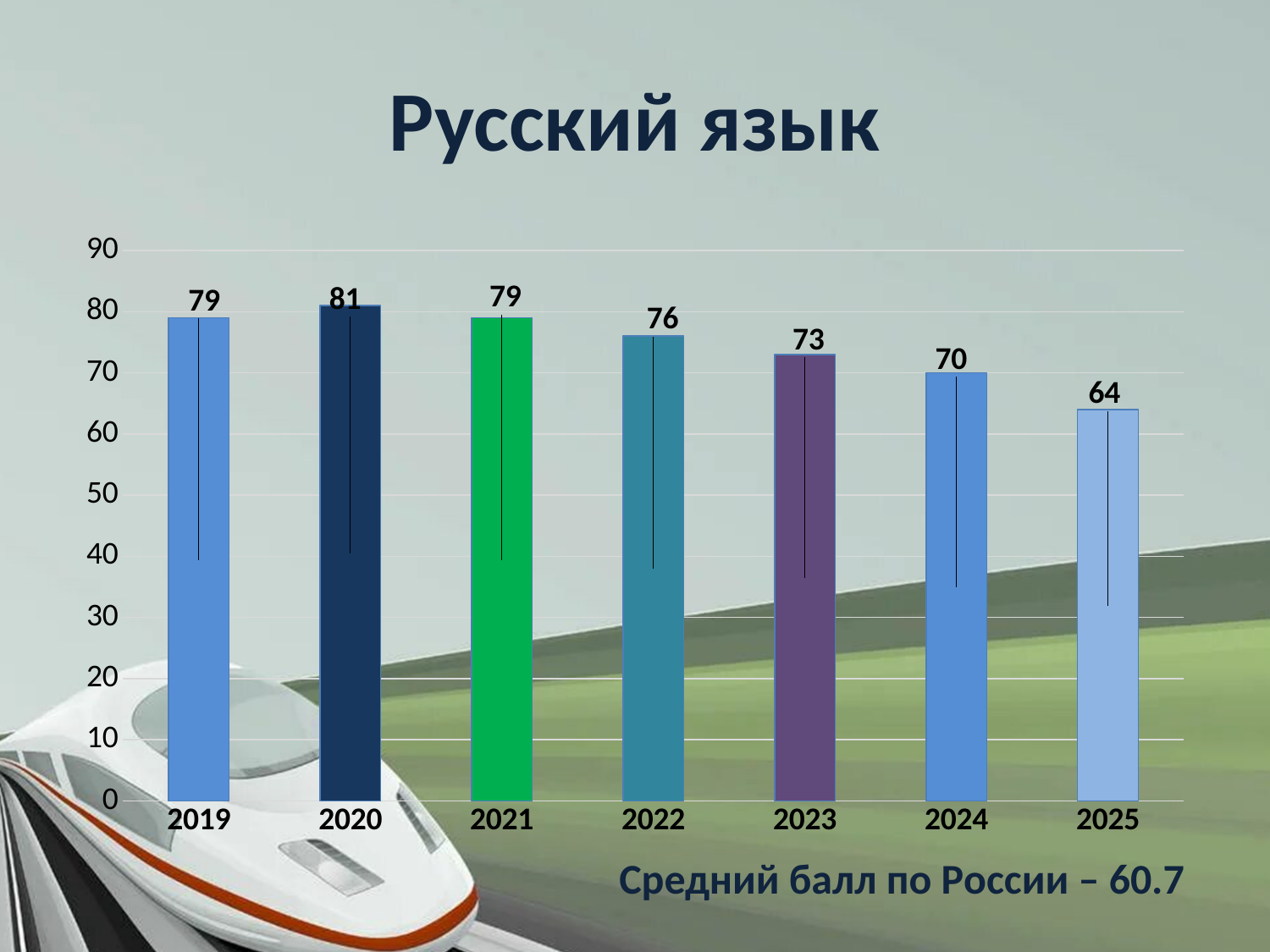
Is the value for 2021 greater or less than 70? greater What is the value for 2022? 76 Which is larger, the value for 2023 or the value for 2024? 2023 How many years are shown on the x axis? 7 Do the values rise or fall from 2021 to 2025? fall What kind of chart is this? bar chart What is the difference between the values for 2020 and 2025? 17 What is the title of the slide? Русский язык What is the value for 2020? 81 Which year has the lowest value? 2025 Which year has the highest value? 2020 What is the value for 2025? 64